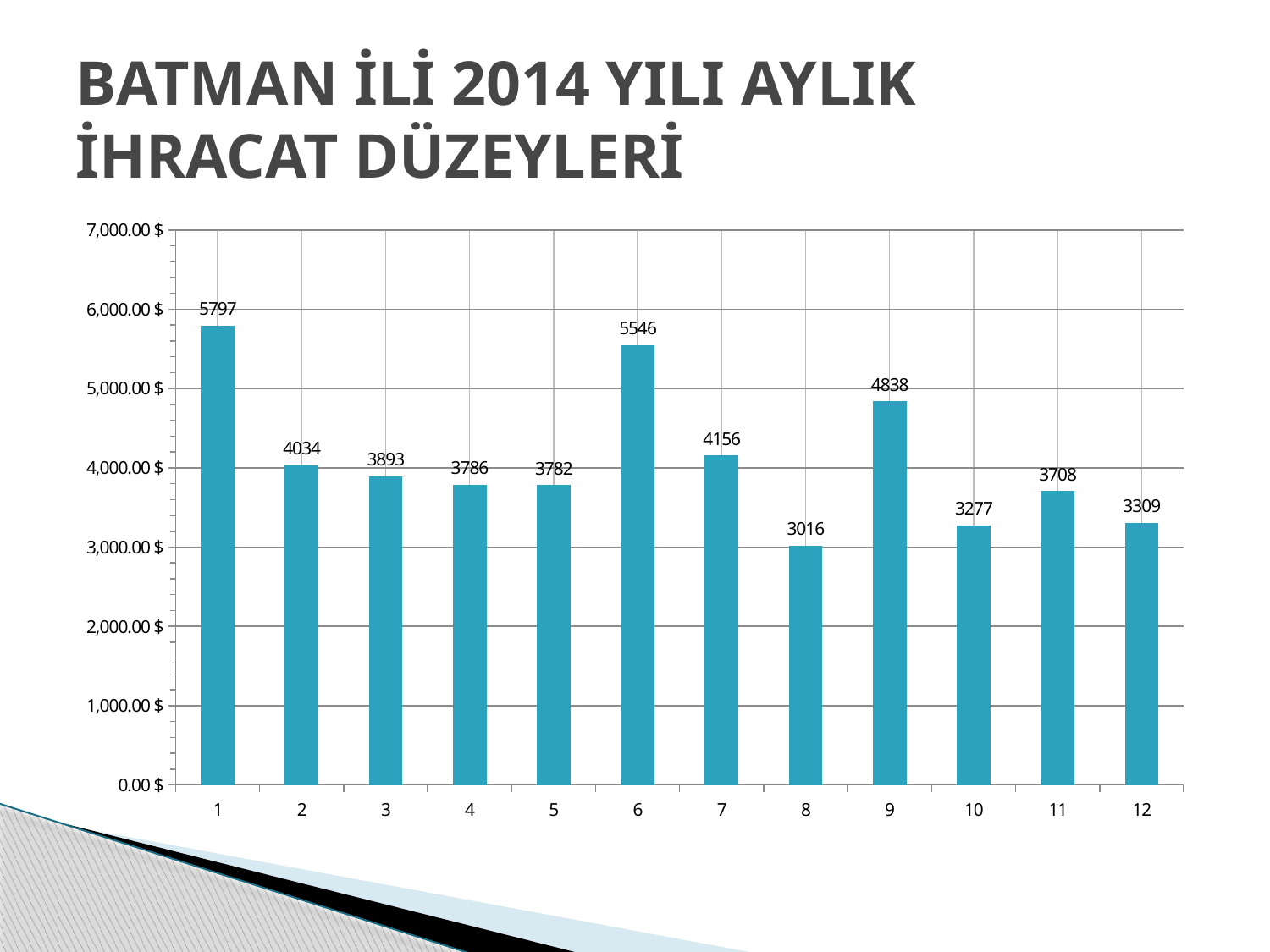
What is the value for month 9? 4838 Which month has the lowest value? 8 What is the difference between the values for month 9 and month 8? 1822 What is the value for month 1? 5797 How many months are shown on the x axis? 12 Do the values rise or fall from month 6 to month 8? fall Which month has the highest value? 1 Which is larger, the value for month 7 or the value for month 11? month 7 What is the value for month 12? 3309 What is the difference between the values for month 1 and month 6? 251 What kind of chart is shown on the slide? bar chart Is the value for month 10 greater or less than 3,000.00 $? greater